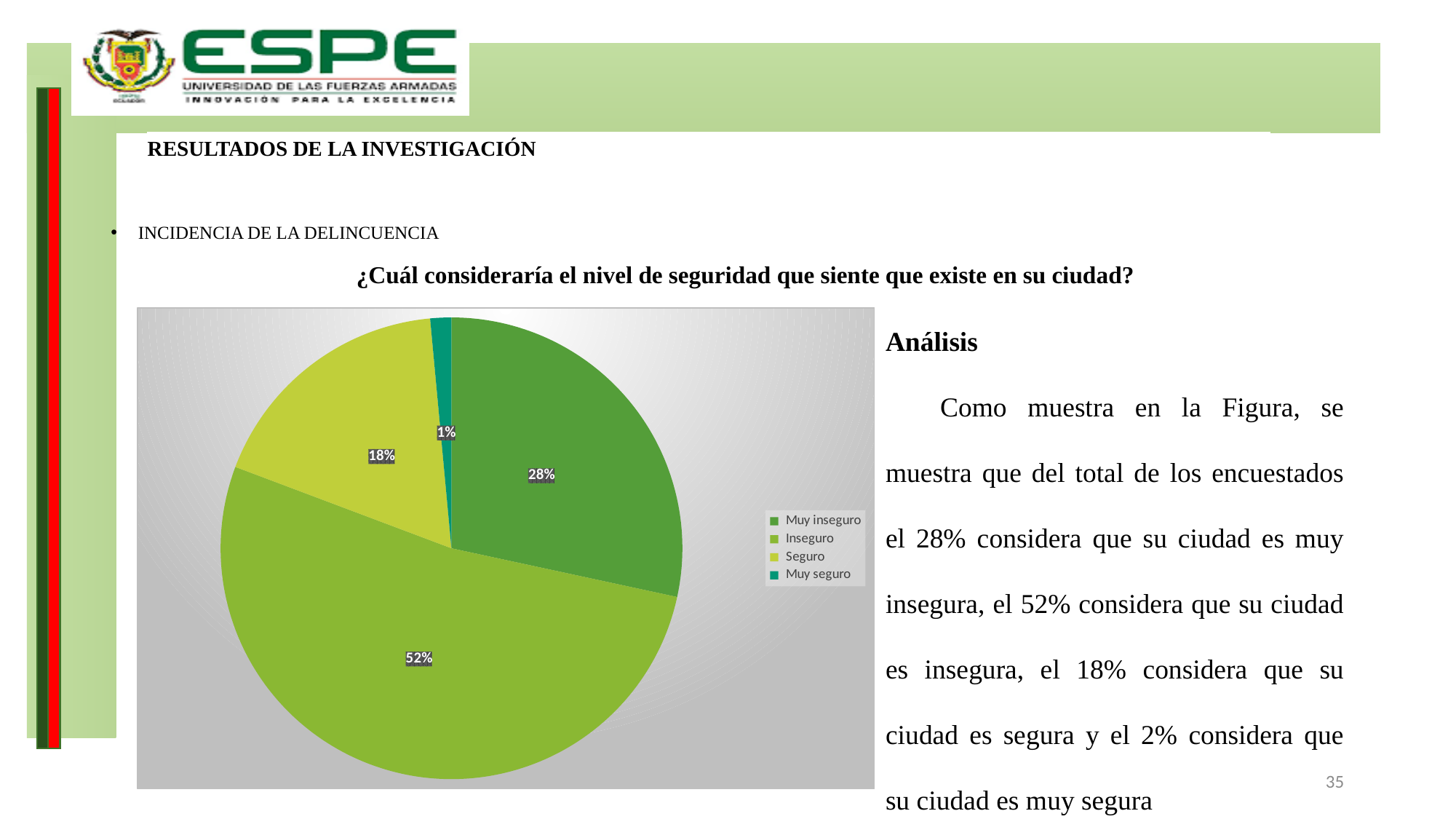
Which is larger, the share for "Seguro" or the share for "Muy inseguro"? Muy inseguro What percentage of respondents answered "Inseguro"? 52% What percentage of respondents answered "Seguro"? 18% What percentage is shown for the "Muy seguro" slice? 1% What percentage of respondents answered "Muy inseguro"? 28% How many categories does the legend list? 4 Which category has the largest share of the pie? Inseguro What kind of chart is shown on the slide? pie chart What question is the chart titled with? ¿Cuál consideraría el nivel de seguridad que siente que existe en su ciudad? What is the difference in percentage points between "Inseguro" and "Muy inseguro"? 24 Which category has the smallest share of the pie? Muy seguro